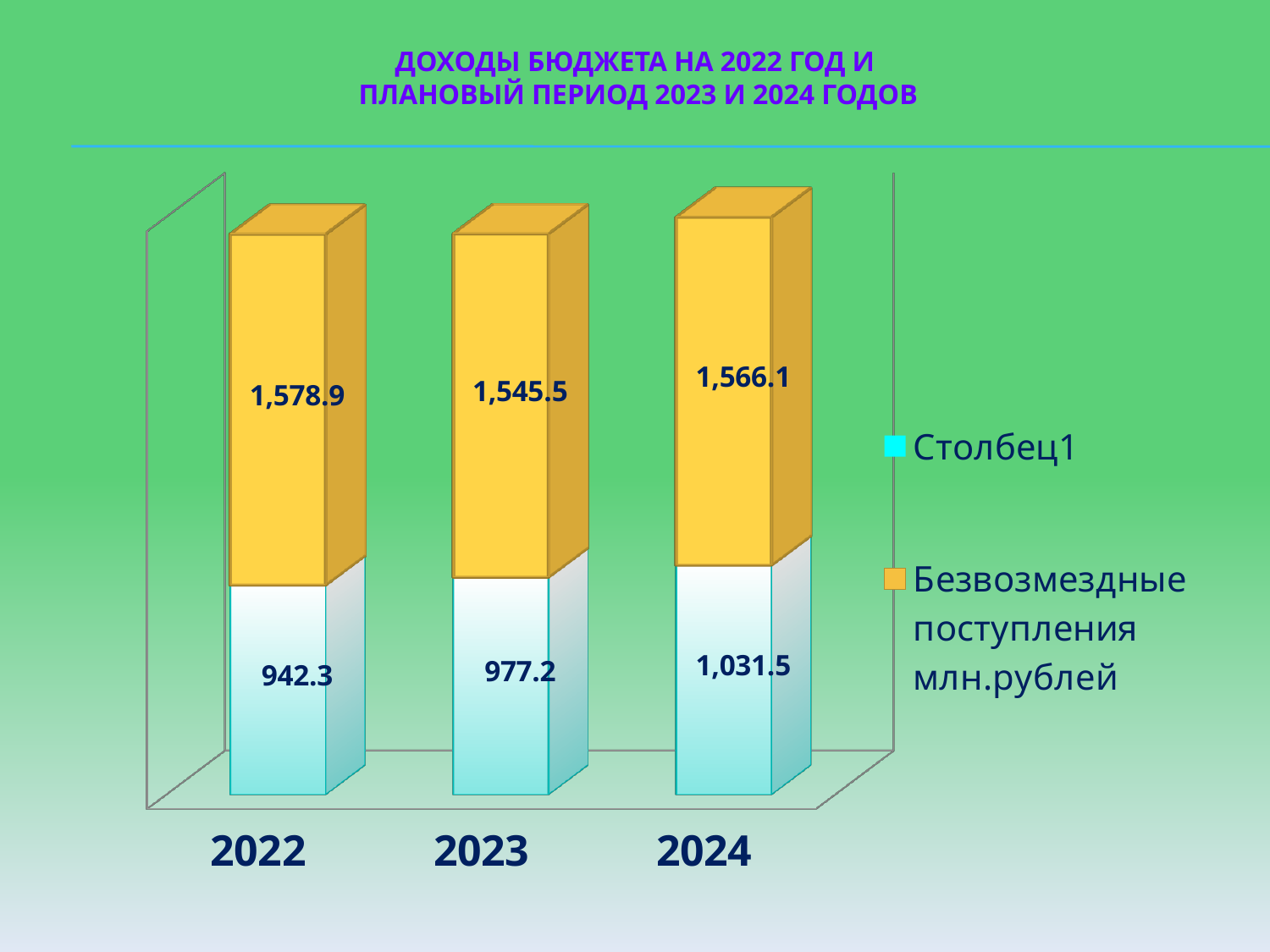
Which is larger: Столбец1 in 2024 or Столбец1 in 2022? Столбец1 in 2024 How many years are shown on the x axis? 3 In which year is Безвозмездные поступления the highest? 2022 What kind of chart is shown on the slide? Stacked bar chart Does the value of Столбец1 rise or fall from 2022 to 2024? Rise What is the value of Безвозмездные поступления for 2022? 1,578.9 What is the total of the stacked bar for 2024? 2,597.6 How many series does the legend list? 2 What is the value of Столбец1 for 2024? 1,031.5 In which year is Столбец1 the lowest? 2022 What is the difference between Безвозмездные поступления in 2022 and 2023? 33.4 What is the value of Столбец1 for 2023? 977.2